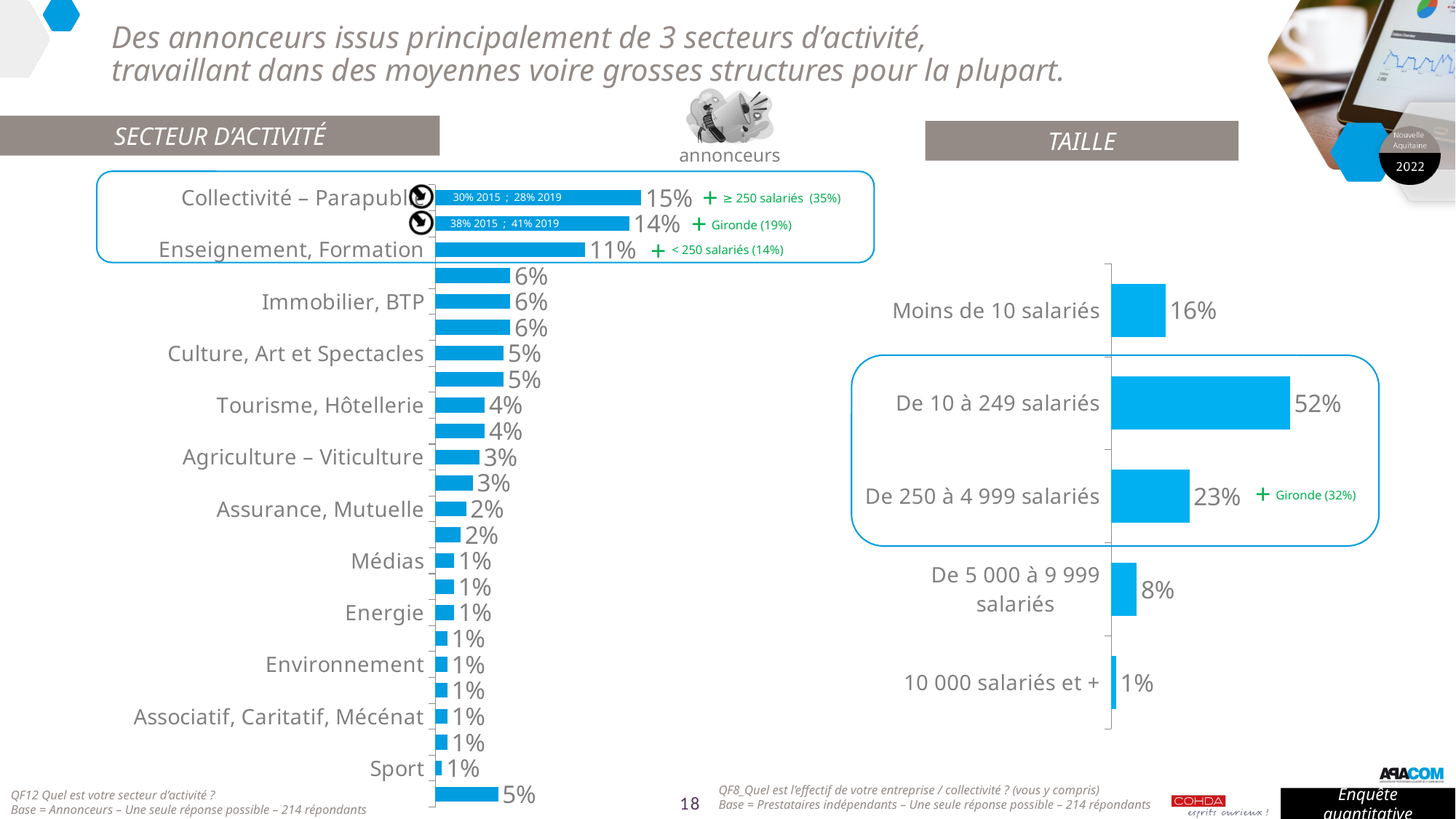
What is the title of the chart on the right side of the slide? TAILLE In the SECTEUR D'ACTIVITÉ chart, what is the value for Agriculture – Viticulture? 3% In the TAILLE chart, which category has the lowest value? 10 000 salariés et + In the SECTEUR D'ACTIVITÉ chart, which is larger: Immobilier, BTP or Tourisme, Hôtellerie? Immobilier, BTP How many categories are shown in the TAILLE chart? 5 In the TAILLE chart, what is the difference between Moins de 10 salariés and De 5 000 à 9 999 salariés? 8 percentage points What kind of chart is the TAILLE chart? Bar chart In the SECTEUR D'ACTIVITÉ chart, what is the difference between Collectivité – Parapublic and Enseignement, Formation? 4 percentage points In the SECTEUR D'ACTIVITÉ chart, what is the value for Enseignement, Formation? 11% In the TAILLE chart, what is the value for De 10 à 249 salariés? 52% In the SECTEUR D'ACTIVITÉ chart, what is the value for Collectivité – Parapublic? 15% In the TAILLE chart, which category has the highest value? De 10 à 249 salariés